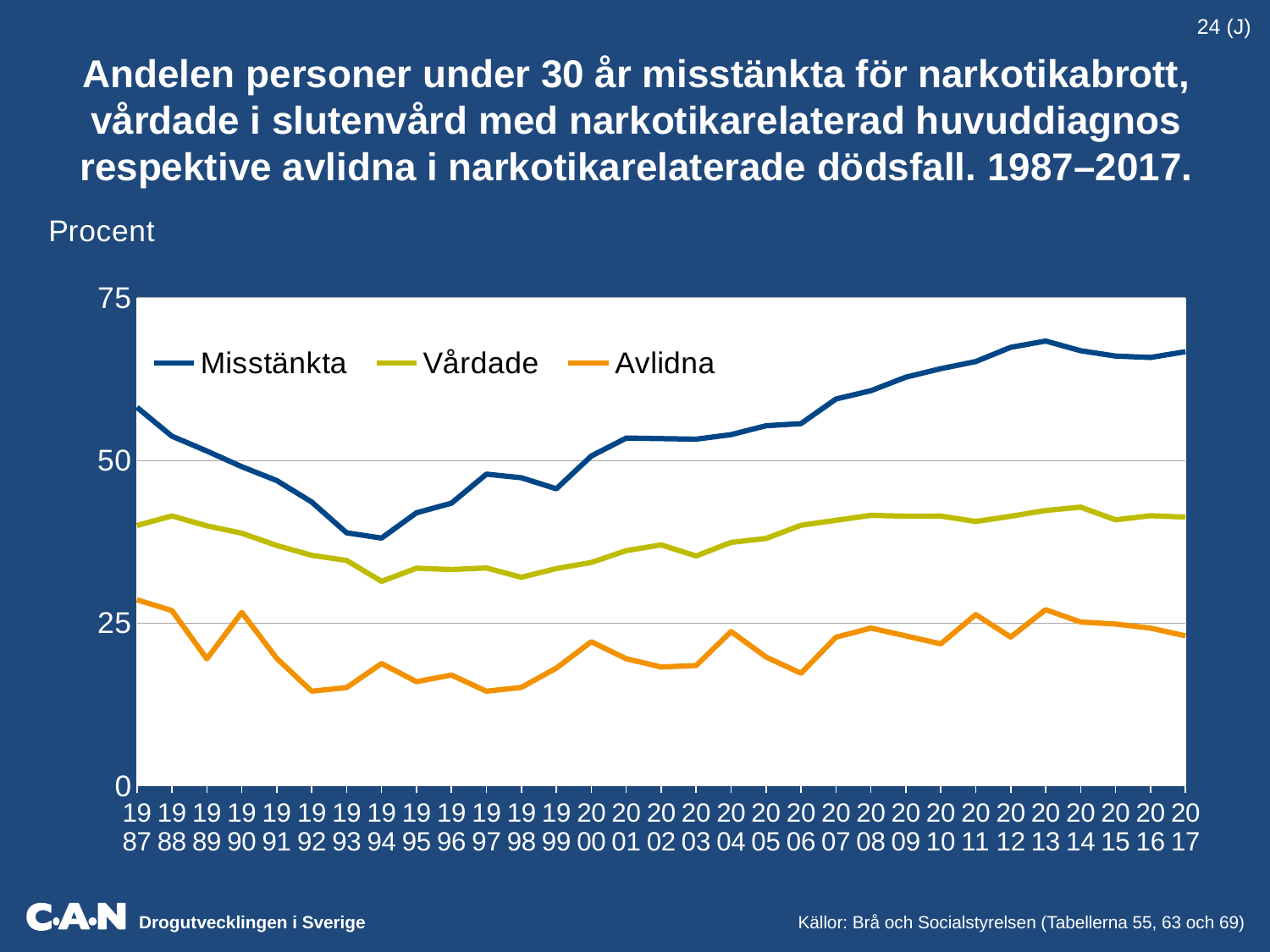
Is the value for Misstänkta in 1994 greater or less than 50? less Is the value for Avlidna in 1987 greater or less than 25? greater What kind of chart is shown on the slide? line chart How many series does the legend list? 3 Is the value for Avlidna in 1992 greater or less than 25? less Which series has the higher value in 1994, Vårdade or Avlidna? Vårdade How many years are plotted along the x axis? 31 Does the Misstänkta line rise or fall between 1987 and 1994? fall What label is shown above the y axis? Procent Which series has the higher value in 2017, Misstänkta or Vårdade? Misstänkta